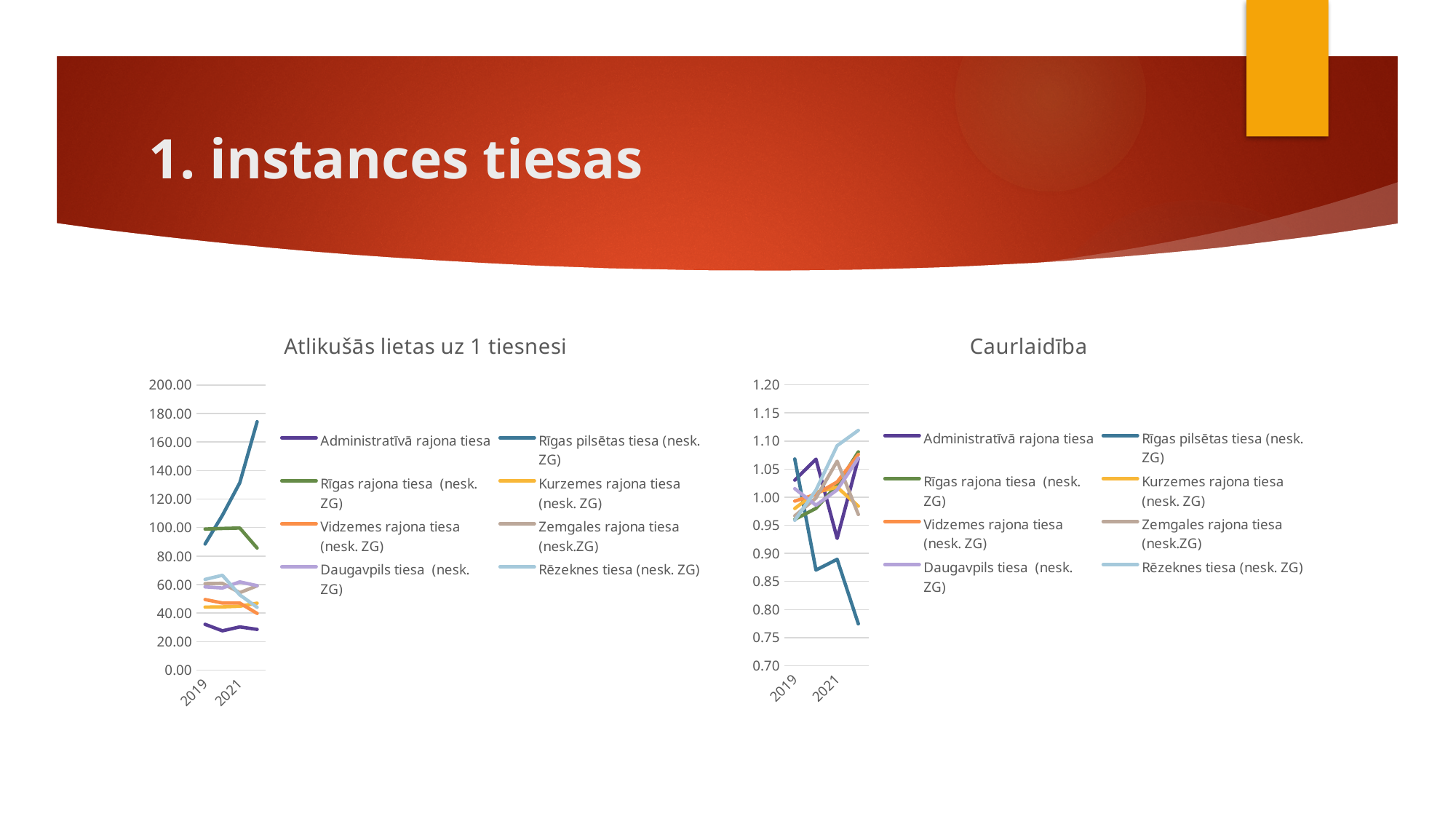
In the "Caurlaidība" chart, does the line for Rīgas pilsētas tiesa (nesk. ZG) rise or fall along the x axis? fall What kind of chart is the chart titled "Atlikušās lietas uz 1 tiesnesi"? line chart How many series does the legend of the "Caurlaidība" chart list? 8 In the "Caurlaidība" chart, which series has the lowest value at the right end of the x axis? Rīgas pilsētas tiesa (nesk. ZG) In the "Caurlaidība" chart, is the final value for Rīgas pilsētas tiesa (nesk. ZG) greater or less than 0.85? less In the "Atlikušās lietas uz 1 tiesnesi" chart, which series has the lowest values across the whole x axis? Administratīvā rajona tiesa In the "Atlikušās lietas uz 1 tiesnesi" chart, does the line for Rīgas pilsētas tiesa (nesk. ZG) rise or fall along the x axis? rise In the "Atlikušās lietas uz 1 tiesnesi" chart, which series has the highest value at the right end of the x axis? Rīgas pilsētas tiesa (nesk. ZG) How many series does the legend of the "Atlikušās lietas uz 1 tiesnesi" chart list? 8 What kind of chart is the chart titled "Caurlaidība"? line chart In the "Atlikušās lietas uz 1 tiesnesi" chart, is the final value for Rīgas pilsētas tiesa (nesk. ZG) greater or less than 160.00? greater What is the title of the chart on the right side of the slide? Caurlaidība